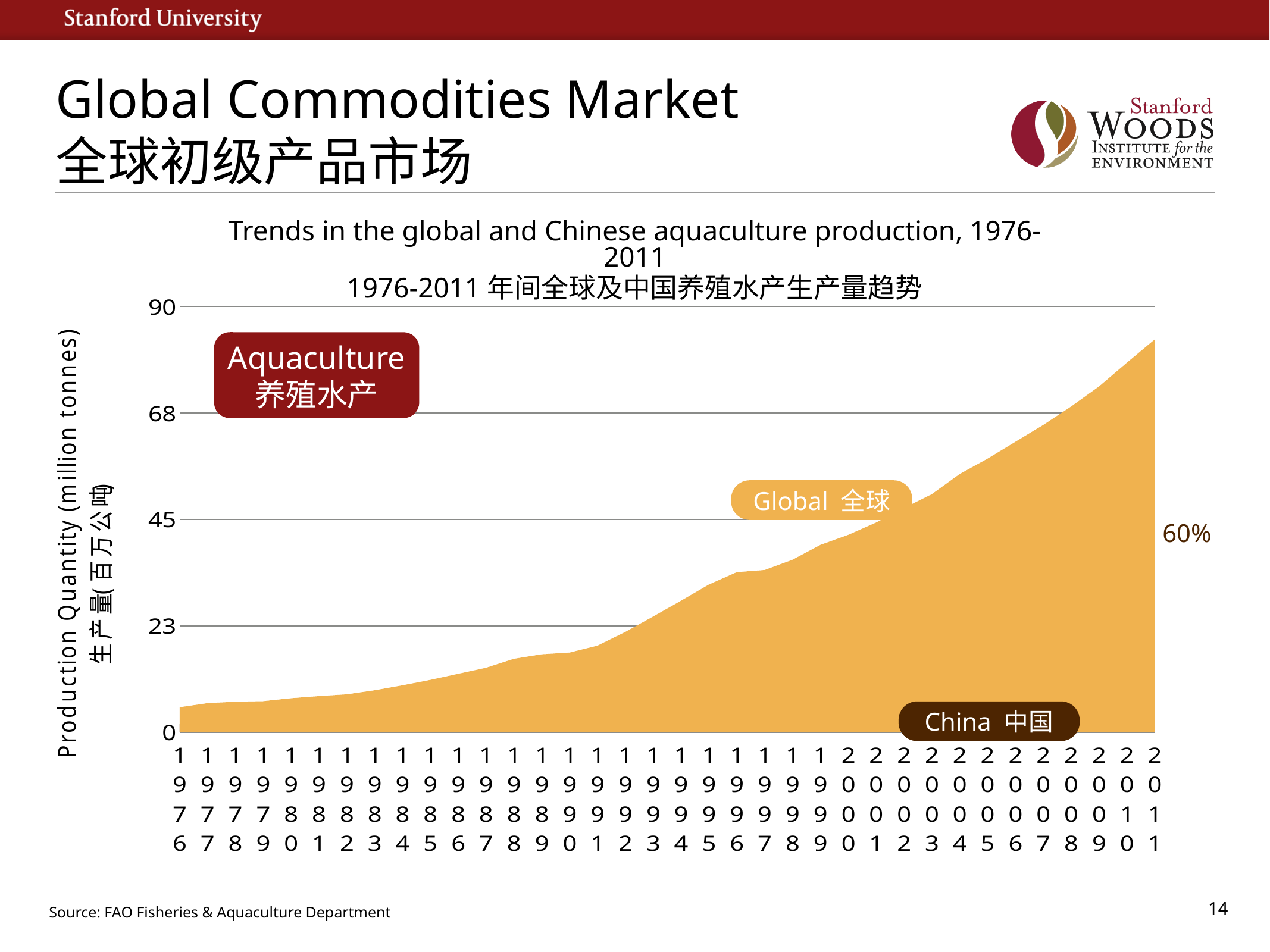
Is the production value for 1976 greater or less than 23 million tonnes? less Is the production value for 2011 greater or less than 68 million tonnes? greater Is the production value for 2005 greater or less than 45 million tonnes? greater What is the label of the y axis of the chart? Production Quantity (million tonnes) Which year has the lowest aquaculture production value on the chart? 1976 What percentage is annotated at the right edge of the chart? 60% Which year has the highest aquaculture production value on the chart? 2011 How many years are plotted along the x axis of the chart? 36 Does global aquaculture production rise or fall from 1976 to 2011? rise What kind of chart is shown on the slide? area chart